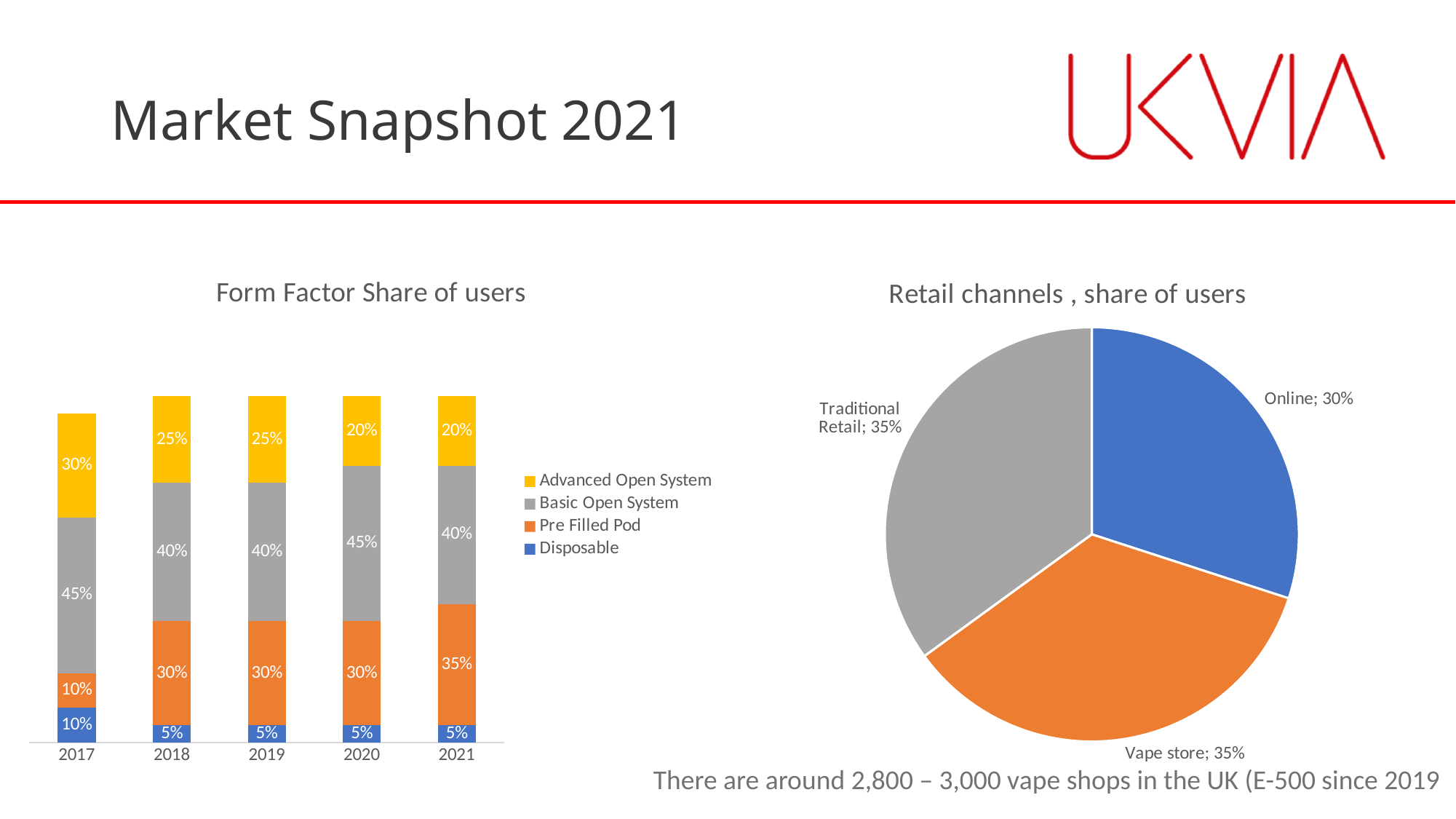
In the 'Form Factor Share of users' chart, how many years are shown on the x axis? 5 In the 'Form Factor Share of users' chart, what is the value for Disposable in 2019? 5% In the 'Form Factor Share of users' chart, which year has the highest value for Basic Open System? 2017 and 2020 (tied at 45%) In the 'Form Factor Share of users' chart, what is the value for Advanced Open System in 2017? 30% In the 'Form Factor Share of users' chart, how many series does the legend list? 4 In the 'Form Factor Share of users' chart, does the Advanced Open System value rise or fall from 2017 to 2021? Fall In the 'Retail channels , share of users' pie chart, how many slices are there? 3 In the 'Form Factor Share of users' chart, what is the difference between the Pre Filled Pod value in 2021 and in 2017? 25% In the 'Retail channels , share of users' pie chart, what share does Online have? 30% What kind of chart is 'Form Factor Share of users'? Stacked bar chart In the 'Form Factor Share of users' chart, what is the value for Pre Filled Pod in 2021? 35% In the 'Form Factor Share of users' chart, which is larger in 2018: Basic Open System or Advanced Open System? Basic Open System